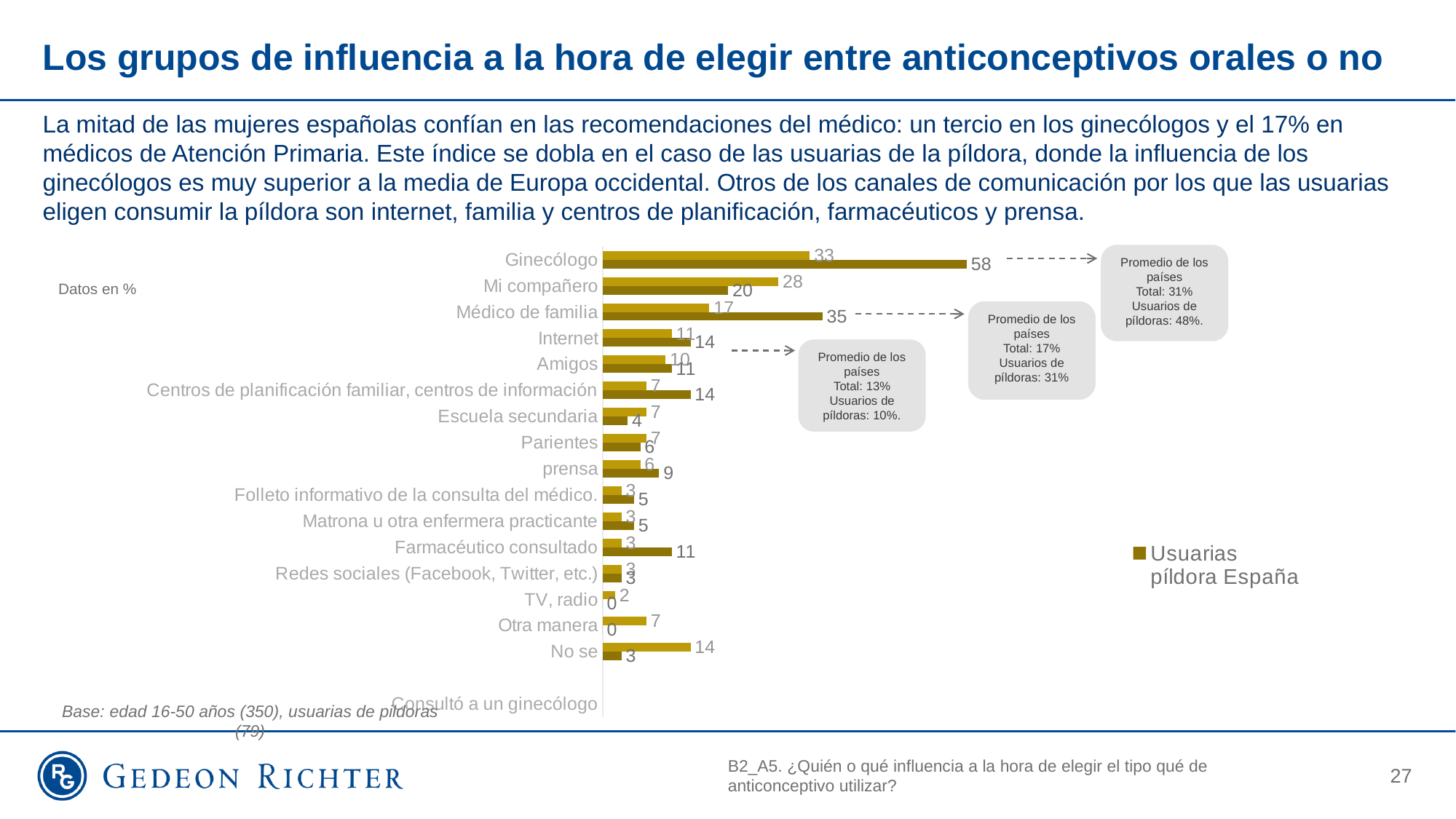
What is the value for Ginecólogo in the Usuarias píldora España series? 58 For Médico de familia, which bar is larger: the Usuarias píldora España bar (35) or the lighter bar (17)? Usuarias píldora España What is the value for Farmacéutico consultado in the Usuarias píldora España series? 11 According to the note next to the chart, in what unit are the data given? % What is the value for Mi compañero in the Usuarias píldora España series? 20 What kind of chart is shown on the slide? bar chart What series name is shown in the chart legend? Usuarias píldora España What is the difference between the two bars for Ginecólogo (58 and 33)? 25 What is the value of the lighter bar for No se? 14 Which category has the highest value in the Usuarias píldora España series? Ginecólogo What is the difference between the two bars for Farmacéutico consultado (11 and 3)? 8 What is the value for TV, radio in the Usuarias píldora España series? 0